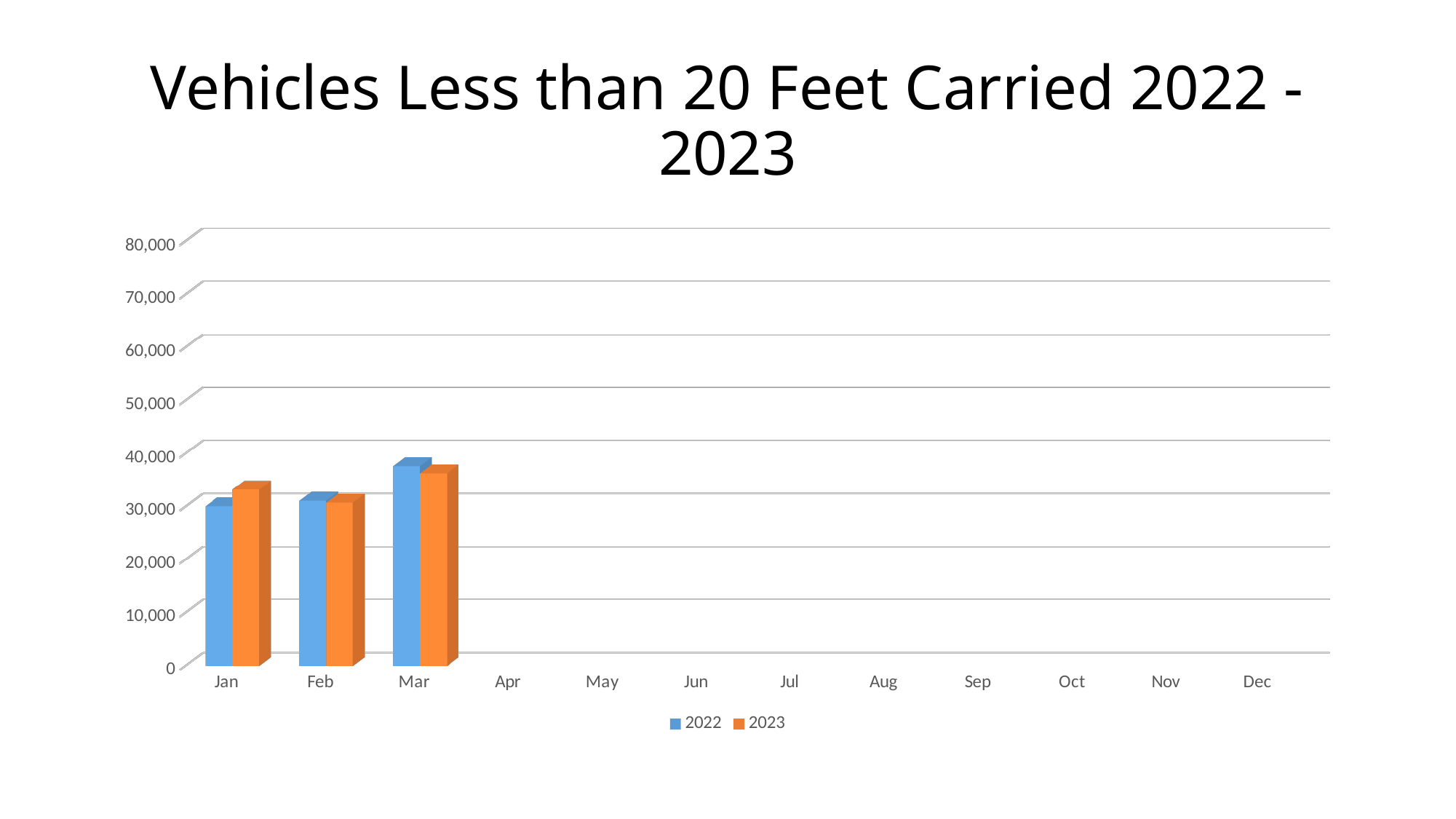
For Jan, which series has the larger value, 2022 or 2023? 2023 How many months on the x axis have bars plotted? 3 Which month has the highest value for the 2022 series? Mar Is the value for Mar 2022 greater or less than 30,000? greater What is the title of the chart? Vehicles Less than 20 Feet Carried 2022 - 2023 Which month has the lowest value for the 2023 series? Feb Is the value for Jan 2022 greater or less than 40,000? less How many month categories are labelled on the x axis? 12 Do the 2022 values rise or fall from Jan to Mar? rise What kind of chart is shown on the slide? bar chart Is the value for Jan 2023 greater or less than 30,000? greater How many series does the legend list? 2